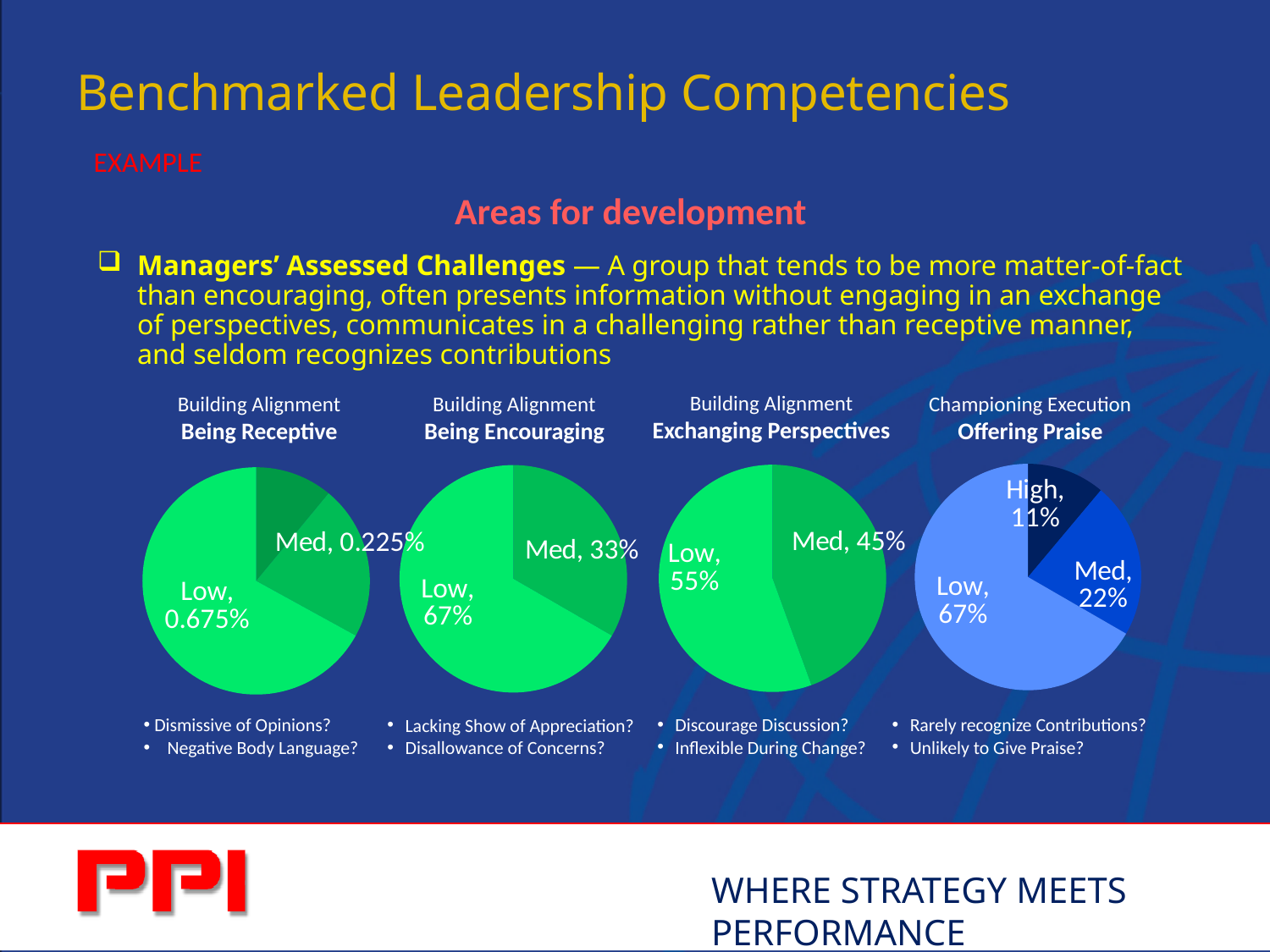
In the Being Encouraging pie chart, what is the value for Low? 67% In the Offering Praise pie chart, which category has the largest slice? Low In the Offering Praise pie chart, which category has the smallest slice? High In the Being Encouraging pie chart, what is the value for Med? 33% What kind of chart is used for Offering Praise? Pie chart In the Exchanging Perspectives pie chart, what is the difference between Low and Med? 10% In the Exchanging Perspectives pie chart, what is the value for Med? 45% In the Offering Praise pie chart, what is the value for High? 11% In the Offering Praise pie chart, what is the value for Med? 22% In the Being Receptive pie chart, what value is printed for Med? 0.225% In the Being Receptive pie chart, what value is printed for Low? 0.675% In the Exchanging Perspectives pie chart, what is the value for Low? 55%